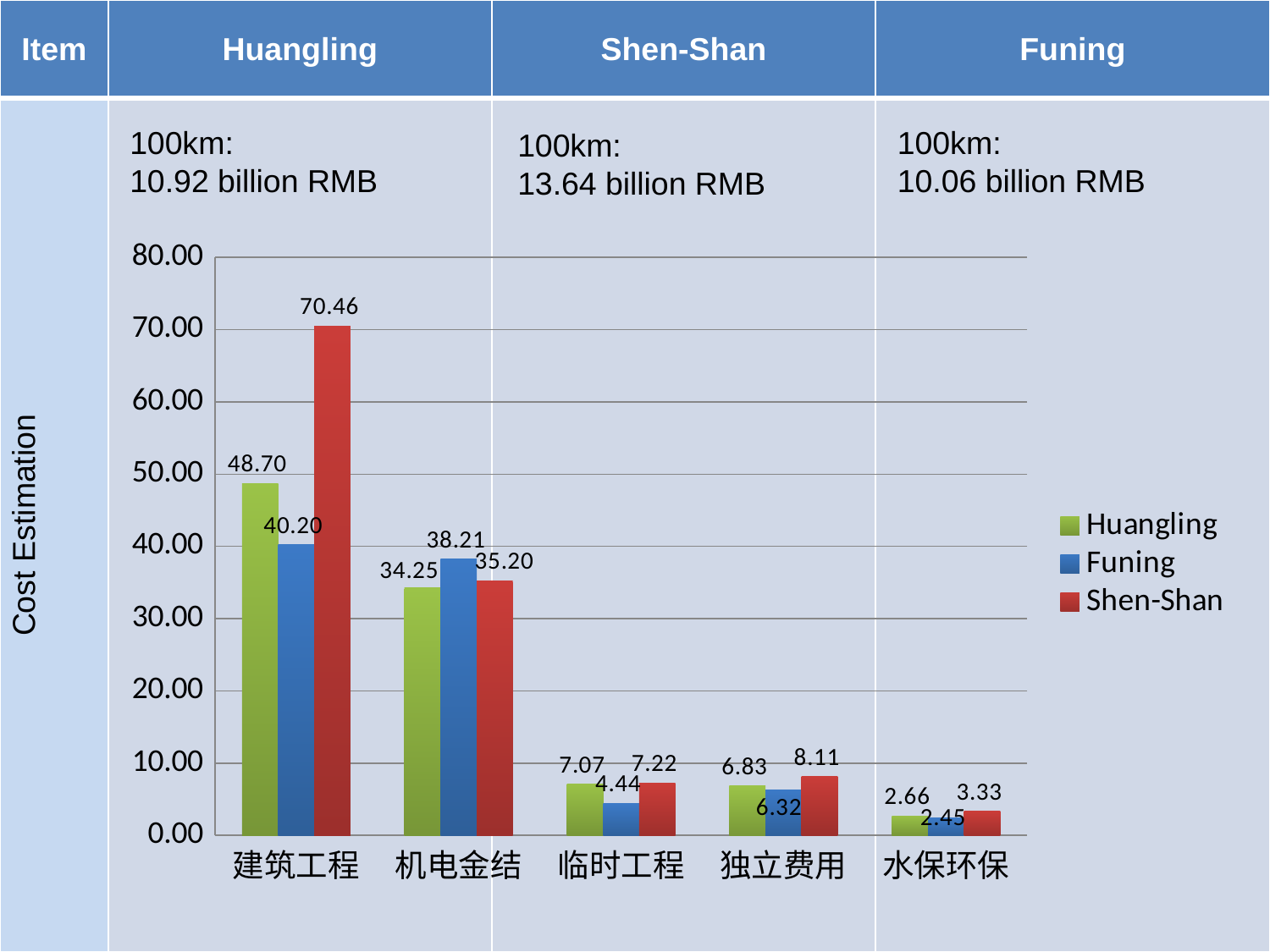
Which category has the highest Shen-Shan value? 建筑工程 What is the Funing value for 水保环保? 2.45 How many series does the legend list? 3 How many categories are shown on the x axis? 5 What kind of chart is shown on the slide? bar chart What is the Funing value for 机电金结? 38.21 Which category has the lowest Huangling value? 水保环保 For 机电金结, which is larger: the Funing value or the Huangling value? Funing Is the Funing value for 建筑工程 greater or less than 50.00? less What is the Huangling value for 临时工程? 7.07 What is the difference between the Shen-Shan and Huangling values for 建筑工程? 21.76 What is the Shen-Shan value for 建筑工程? 70.46